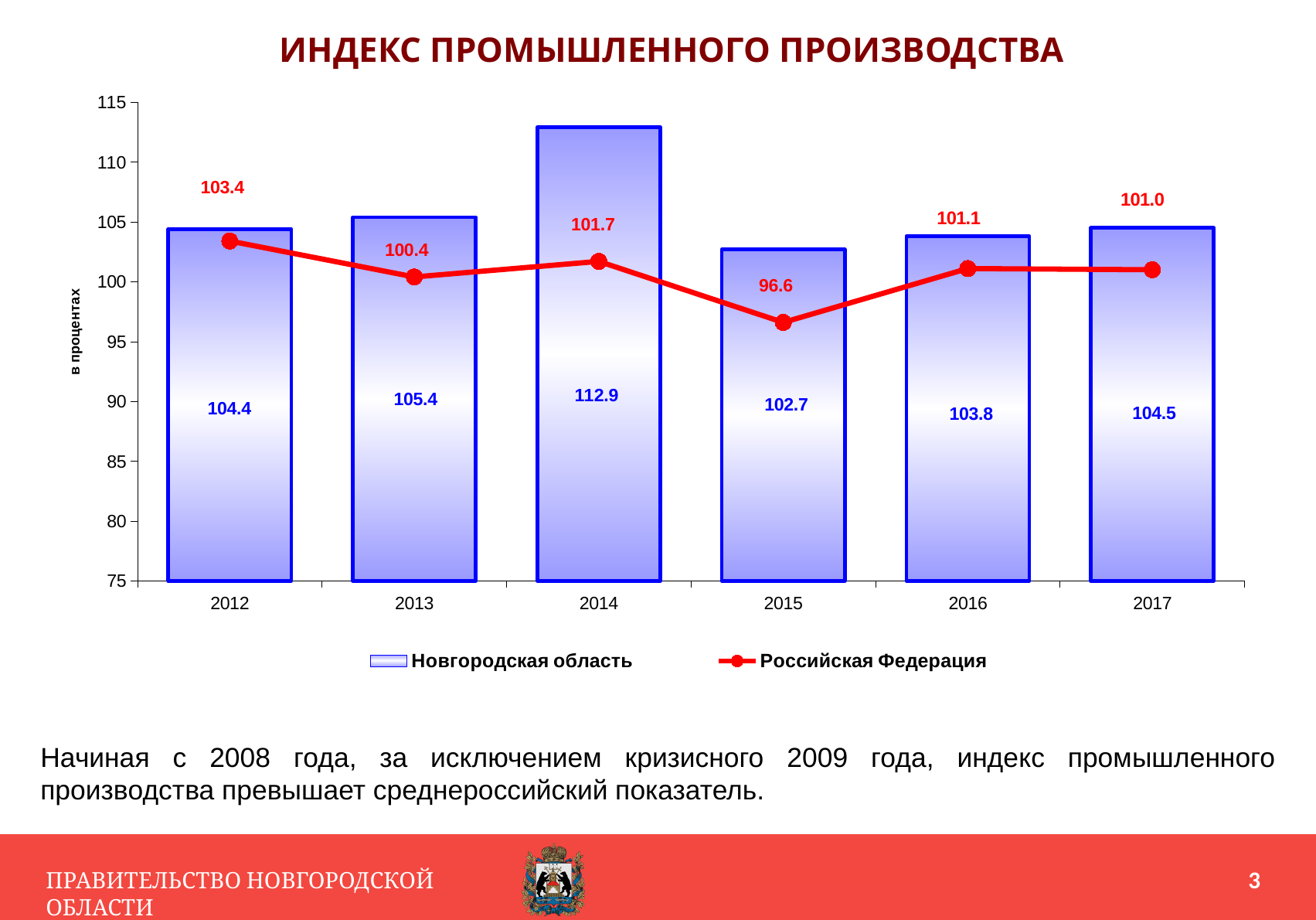
What is the value for Российская Федерация in 2015? 96.6 What is the difference between the Новгородская область and Российская Федерация values in 2014? 11.2 In which year is the value for Российская Федерация lowest? 2015 How many series does the legend list? 2 Does the value for Российская Федерация rise or fall from 2014 to 2015? fall What is the value for Новгородская область in 2017? 104.5 In which year is the value for Новгородская область highest? 2014 What kind of chart is used for the Новгородская область series? bar chart How many years are shown on the x axis? 6 What is the title of the chart? ИНДЕКС ПРОМЫШЛЕННОГО ПРОИЗВОДСТВА Which is larger in 2013: the value for Новгородская область or for Российская Федерация? Новгородская область What is the value for Новгородская область in 2014? 112.9